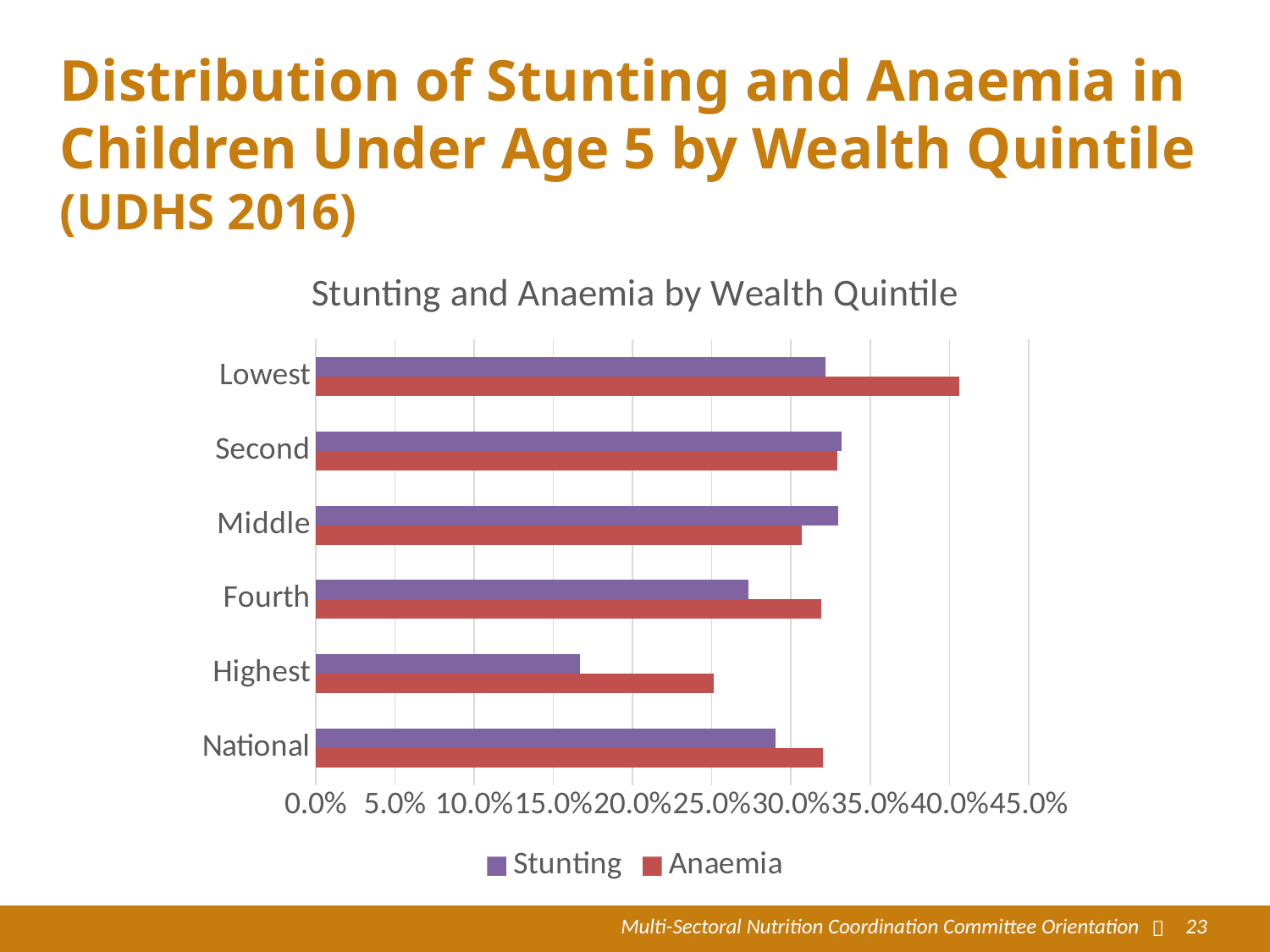
Which category has the lowest Stunting value? Highest What kind of chart is shown on the slide? Bar chart Which category has the lowest Anaemia value? Highest How many series does the legend list? 2 How many categories are shown on the vertical axis of the chart? 6 What is the title of the chart? Stunting and Anaemia by Wealth Quintile Which category has the highest Anaemia value? Lowest For the Middle quintile, which is larger: Stunting or Anaemia? Stunting Is the Stunting value for Highest greater or less than 20.0%? less For the Lowest quintile, which is larger: Stunting or Anaemia? Anaemia Is the Anaemia value for Lowest greater or less than 35.0%? greater Is the Stunting value for Fourth greater or less than 25.0%? greater